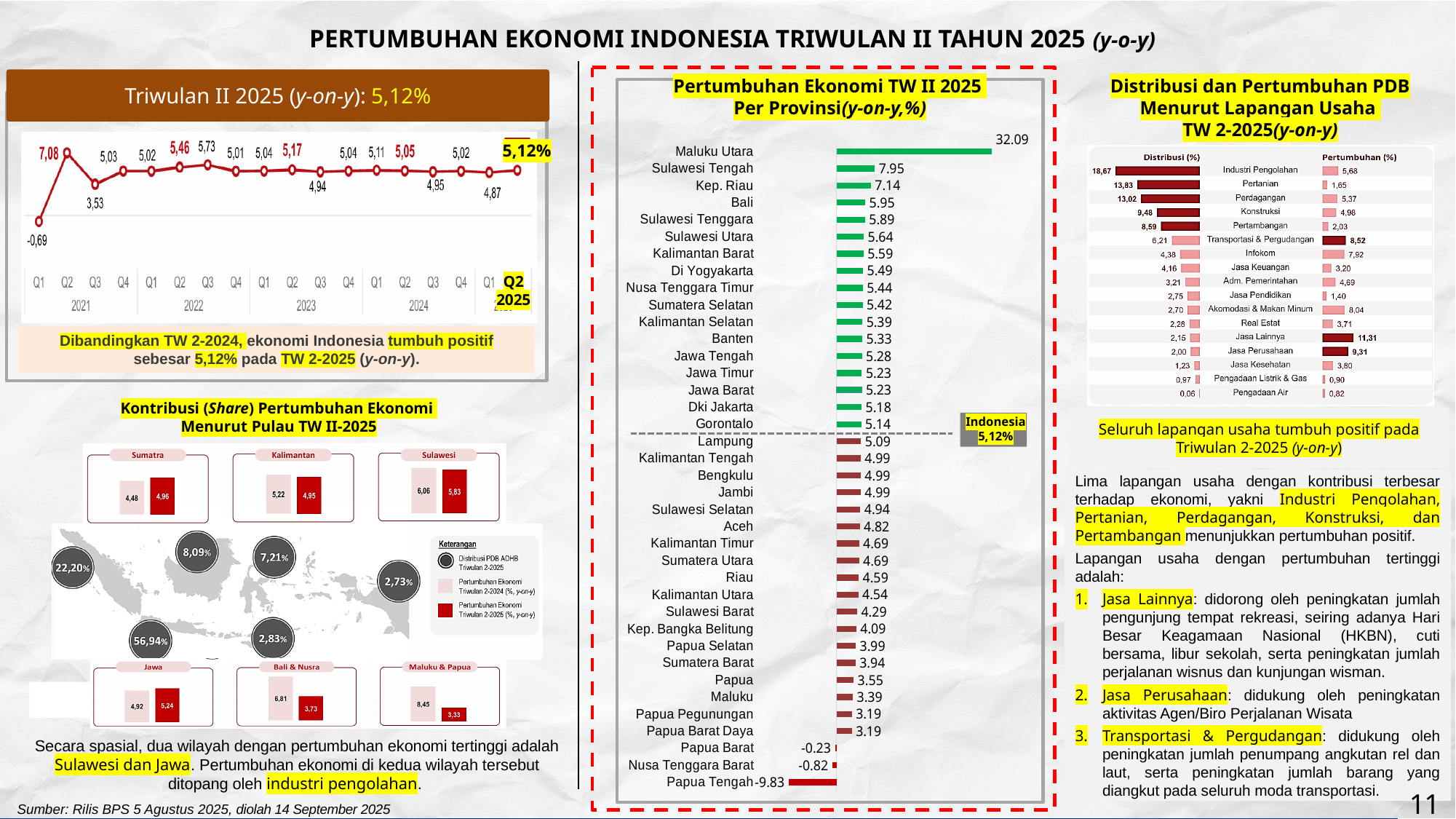
In the 'Pertumbuhan Ekonomi TW II 2025 Per Provinsi' chart, what is the value for Nusa Tenggara Barat? -0.82 In the top-left quarterly growth line chart, what is the value for Q2 2021? 7,08 In the 'Pertumbuhan Ekonomi TW II 2025 Per Provinsi' chart, what is the value for Maluku Utara? 32.09 In the 'Kontribusi (Share) Pertumbuhan Ekonomi Menurut Pulau TW II-2025' chart, what is the share for Jawa? 56,94% What kind of chart is the 'Pertumbuhan Ekonomi TW II 2025 Per Provinsi' chart? Bar chart In the 'Pertumbuhan Ekonomi TW II 2025 Per Provinsi' chart, how many provinces are plotted? 38 In the 'Distribusi dan Pertumbuhan PDB Menurut Lapangan Usaha' chart, which sector has the highest growth (Pertumbuhan)? Jasa Lainnya In the top-left quarterly growth line chart, which quarter has the lowest value? Q1 2021 In the 'Pertumbuhan Ekonomi TW II 2025 Per Provinsi' chart, which province has the highest growth? Maluku Utara In the 'Pertumbuhan Ekonomi TW II 2025 Per Provinsi' chart, which province has the lowest growth? Papua Tengah In the top-left quarterly growth line chart, which is larger, Q1 2025 or Q2 2025? Q2 2025 In the 'Pertumbuhan Ekonomi TW II 2025 Per Provinsi' chart, what is the difference between Maluku Utara and Sulawesi Tengah? 24.14